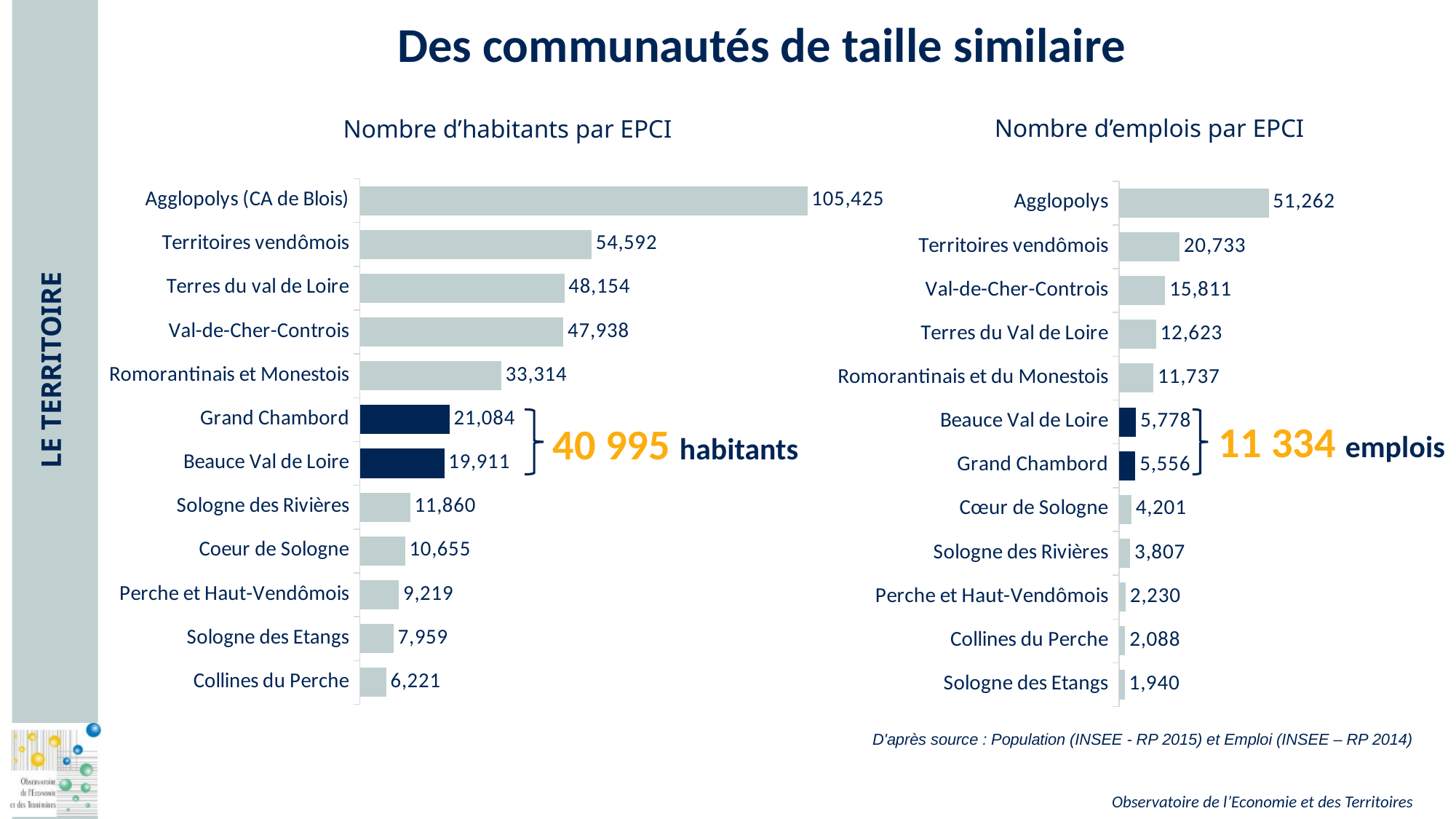
What type of chart is 'Nombre d'emplois par EPCI'? Bar chart In the 'Nombre d'habitants par EPCI' chart, what is the value for Collines du Perche? 6,221 In the 'Nombre d'emplois par EPCI' chart, which EPCI has the lowest number of jobs? Sologne des Etangs How many EPCI categories are shown in the 'Nombre d'habitants par EPCI' chart? 12 In the 'Nombre d'habitants par EPCI' chart, what is the value for Territoires vendômois? 54,592 In the 'Nombre d'habitants par EPCI' chart, which EPCI has the highest number of inhabitants? Agglopolys (CA de Blois) In the 'Nombre d'habitants par EPCI' chart, what is the difference between Grand Chambord and Beauce Val de Loire? 1,173 In the 'Nombre d'emplois par EPCI' chart, what is the difference between Agglopolys and Territoires vendômois? 30,529 In the 'Nombre d'emplois par EPCI' chart, which is larger: Cœur de Sologne or Sologne des Rivières? Cœur de Sologne In the 'Nombre d'habitants par EPCI' chart, which two bars are highlighted in dark blue? Grand Chambord and Beauce Val de Loire In the 'Nombre d'emplois par EPCI' chart, what is the combined total of Beauce Val de Loire and Grand Chambord? 11 334 emplois In the 'Nombre d'emplois par EPCI' chart, what is the value for Val-de-Cher-Controis? 15,811